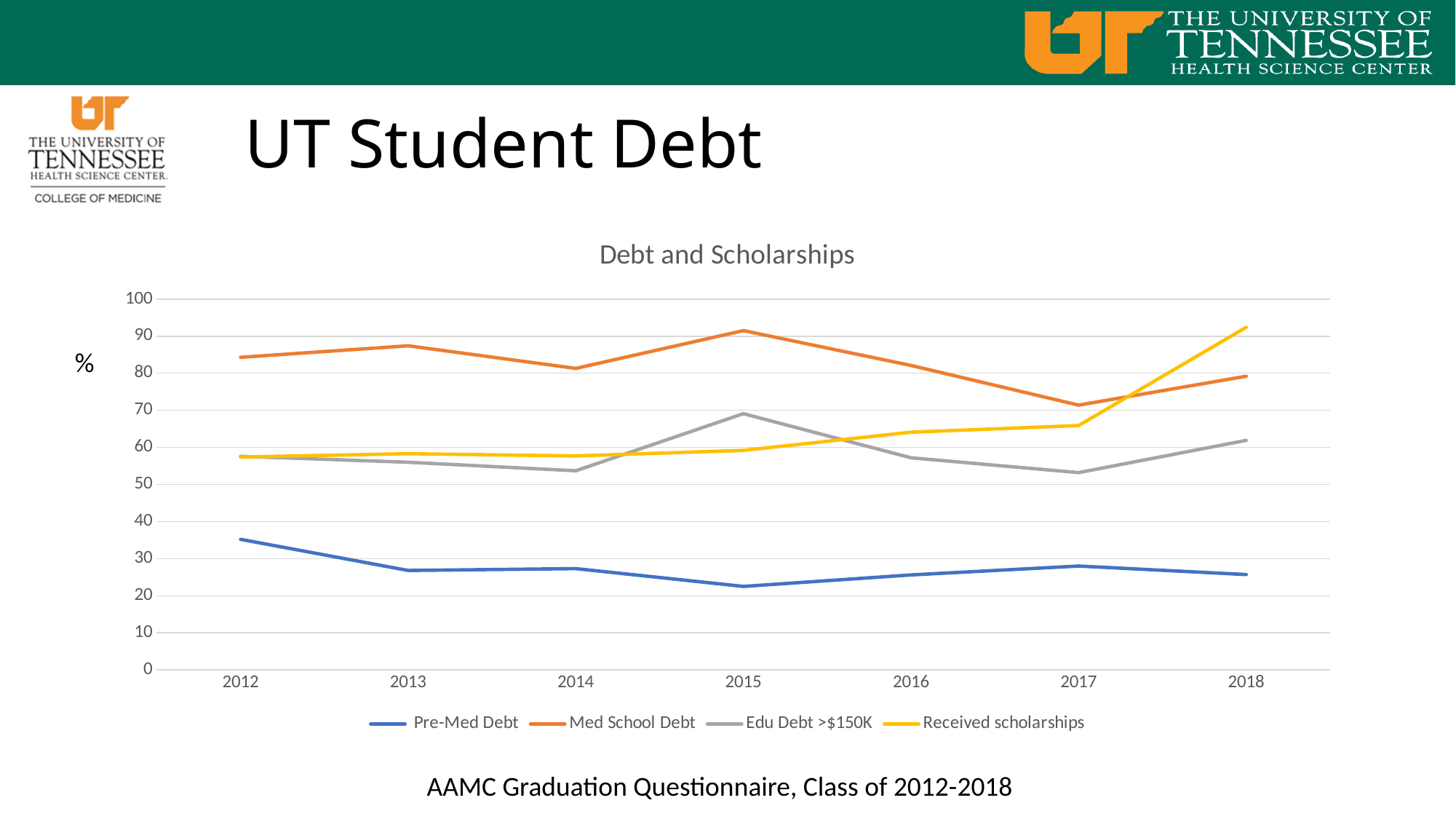
Is the value for Med School Debt in 2017 greater or less than 80? less In which year is the Med School Debt line at its lowest? 2017 What is the title of the chart? Debt and Scholarships What kind of chart is shown on the slide? Line chart In which year does the Received scholarships line reach its highest value? 2018 Is the value for Pre-Med Debt in 2012 greater or less than 30? greater How many series does the legend of the chart list? 4 How many years are plotted along the x axis of the chart? 7 In which year is the Med School Debt line at its highest? 2015 In 2018, which is larger: Received scholarships or Med School Debt? Received scholarships In which year is the Pre-Med Debt line at its lowest? 2015 In which year is the Edu Debt >$150K line at its highest? 2015